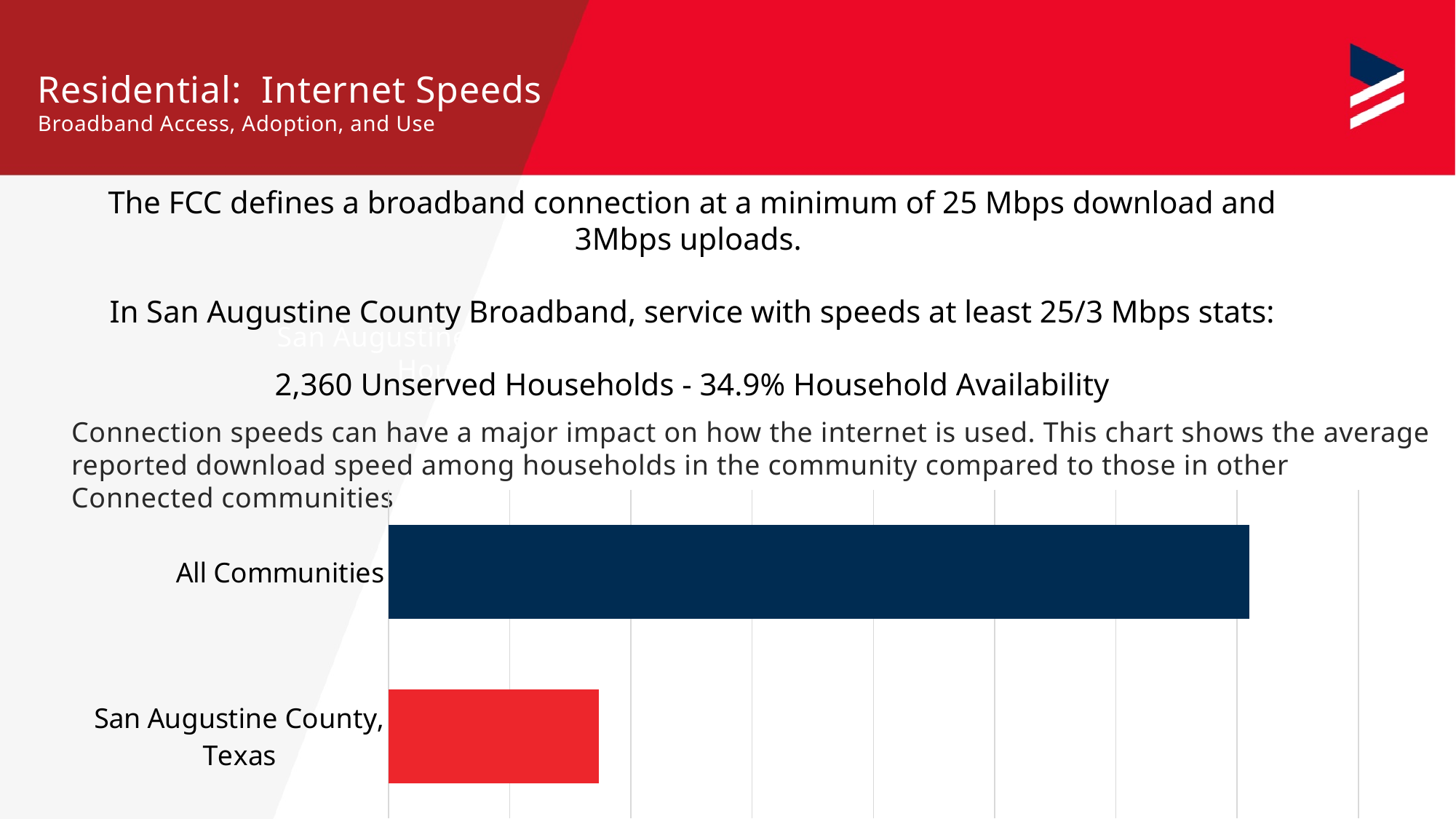
What colour is the bar for San Augustine County, Texas? red How many categories (bars) does the chart show? 2 Which category has the lowest value in the chart? San Augustine County, Texas Which category is listed at the top of the chart? All Communities Which has the larger value: All Communities or San Augustine County, Texas? All Communities Is the bar for San Augustine County, Texas longer or shorter than the bar for All Communities? shorter What colour is the bar for All Communities? dark navy blue Are the bars in the chart horizontal or vertical? horizontal Which category has the highest value in the chart? All Communities What kind of chart is shown on the slide? bar chart